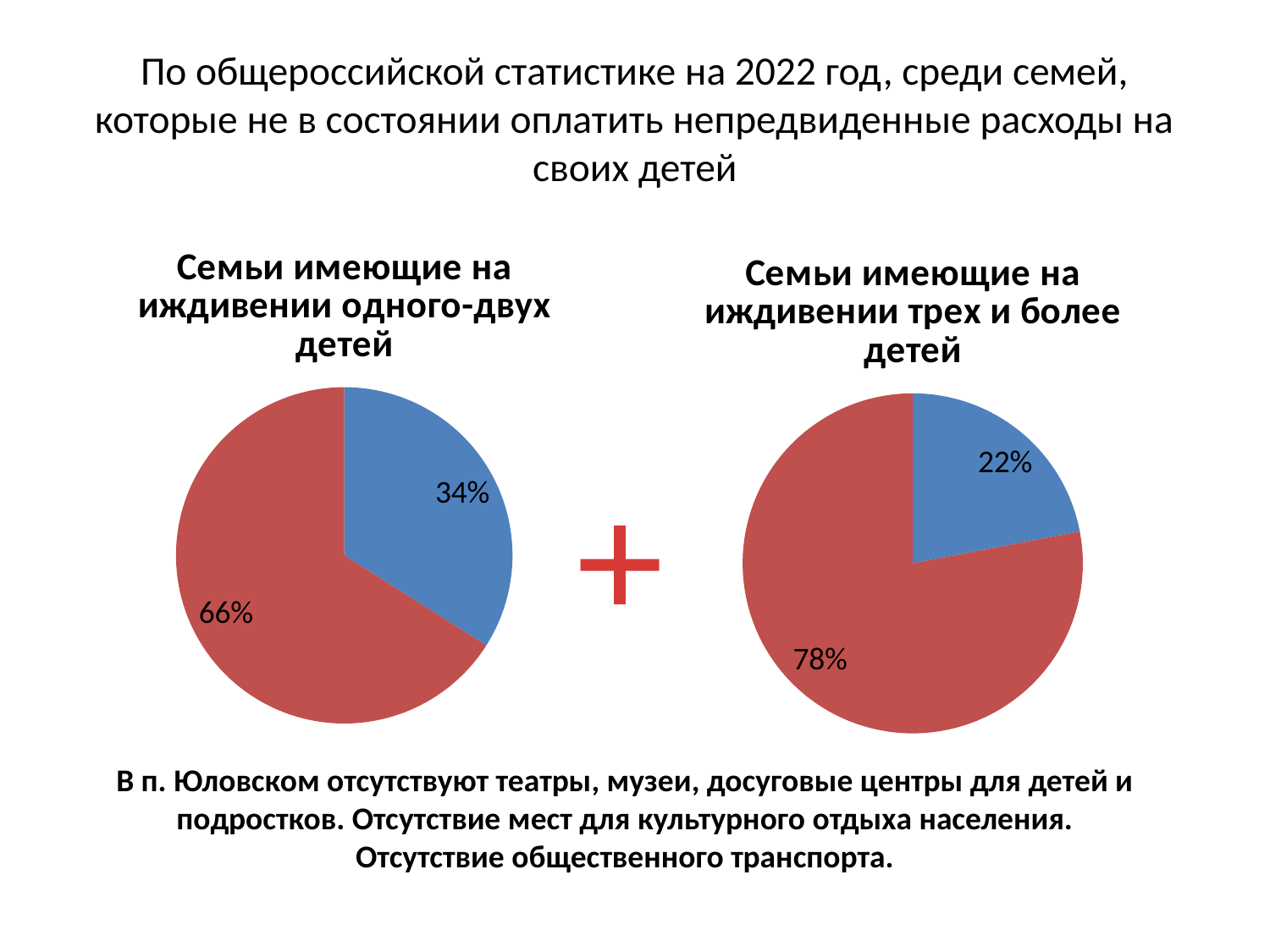
In the right chart ("Семьи имеющие на иждивении трех и более детей"), what percentage is shown for the red slice? 78% What is the difference between the blue slice of the left chart (34%) and the blue slice of the right chart (22%)? 12% What is the difference between the red and blue slices in the right chart ("Семьи имеющие на иждивении трех и более детей")? 56% How many slices does the right chart ("Семьи имеющие на иждивении трех и более детей") have? 2 How many slices does the left chart ("Семьи имеющие на иждивении одного-двух детей") have? 2 In the left chart ("Семьи имеющие на иждивении одного-двух детей"), what percentage is shown for the blue slice? 34% What is the title of the right pie chart? Семьи имеющие на иждивении трех и более детей In the left chart ("Семьи имеющие на иждивении одного-двух детей"), what percentage is shown for the red slice? 66% What kind of chart is the left chart titled "Семьи имеющие на иждивении одного-двух детей"? pie chart In the left chart ("Семьи имеющие на иждивении одного-двух детей"), which slice is larger, the red one or the blue one? the red one In the right chart ("Семьи имеющие на иждивении трех и более детей"), what percentage is shown for the blue slice? 22% In the right chart ("Семьи имеющие на иждивении трех и более детей"), which slice is the smallest? the blue slice (22%)